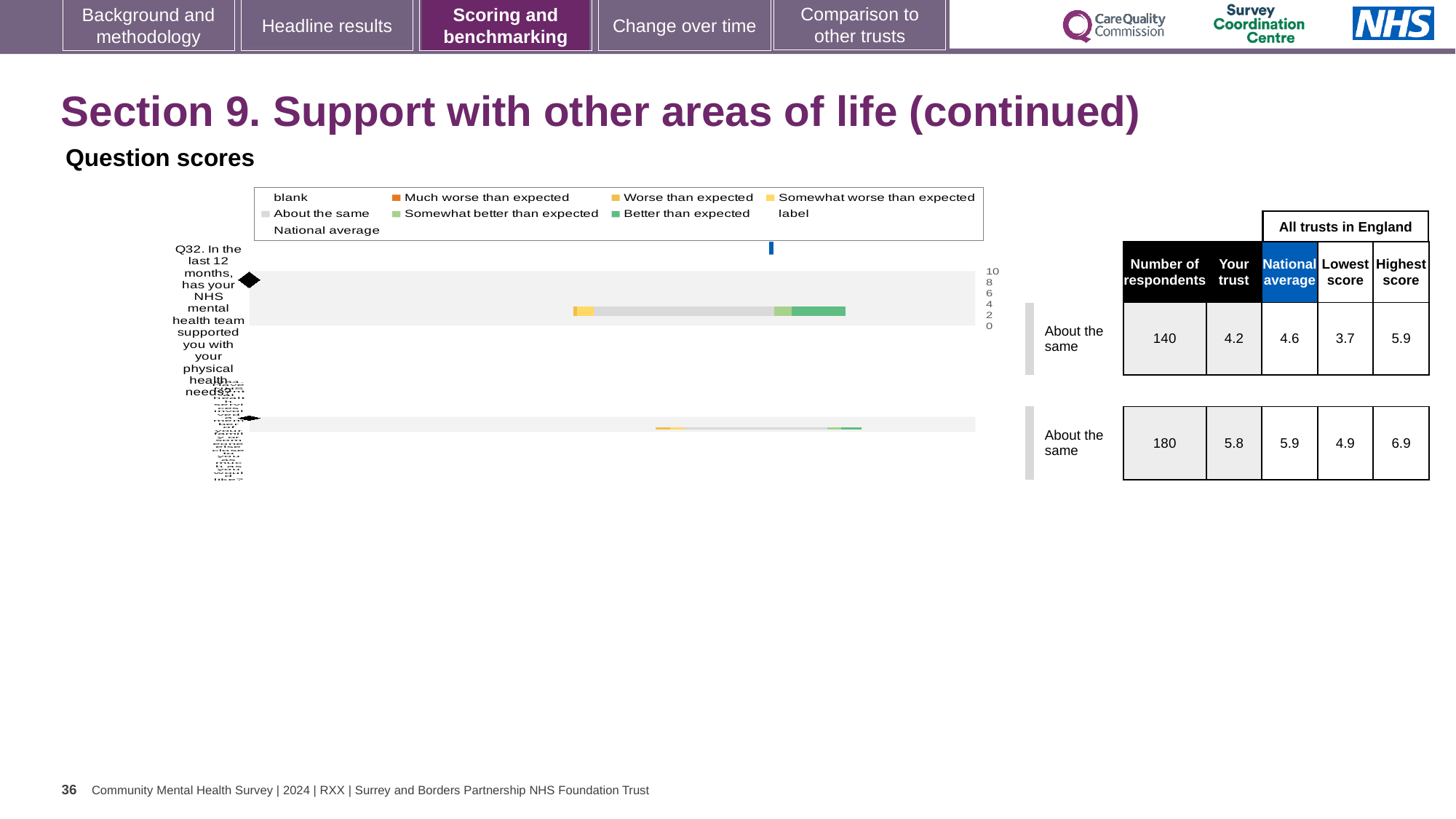
For Q32, which is larger: the trust's score or the national average? National average What is the national average score for Q32? 4.6 How many question rows are plotted on the chart? 2 For Q32, what is the difference between the highest and lowest scores across all trusts in England? 2.2 How is the trust's Q32 score categorised relative to expectations? About the same What is the highest score among all trusts in England for Q32? 5.9 What colour does the legend use for 'Better than expected'? Green What is the lowest score among all trusts in England for Q32? 3.7 How many respondents answered Q32? 140 What is the 'Your trust' score for Q32 (support with physical health needs)? 4.2 For Q32, how much higher is the national average than the trust's score? 0.4 What kind of chart is shown on the slide? bar chart